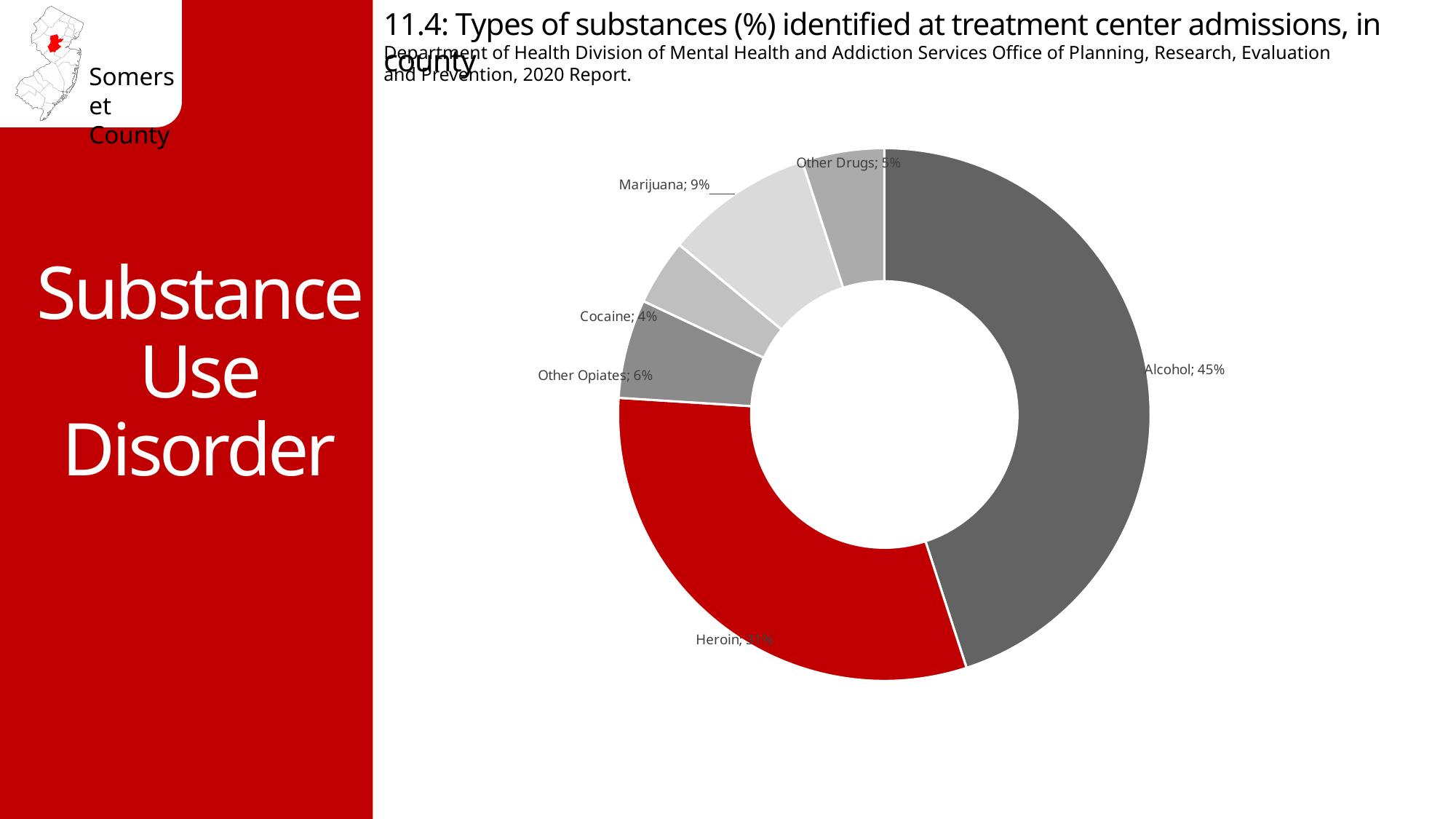
What percentage is shown for Other Opiates? 6% What kind of chart is used on this slide? doughnut chart Which substance has the smallest share of treatment center admissions? Cocaine How many substance categories are shown in the chart? 6 What is the difference in percentage points between Alcohol and Heroin? 14 What percentage is shown for Marijuana? 9% What percentage is shown for Cocaine? 4% Which substance has the largest share of treatment center admissions? Alcohol What percentage of treatment center admissions identified Alcohol as the substance? 45% Which has a larger share, Marijuana or Other Drugs? Marijuana What percentage is shown for Heroin? 31% Which slice of the chart is coloured red? Heroin